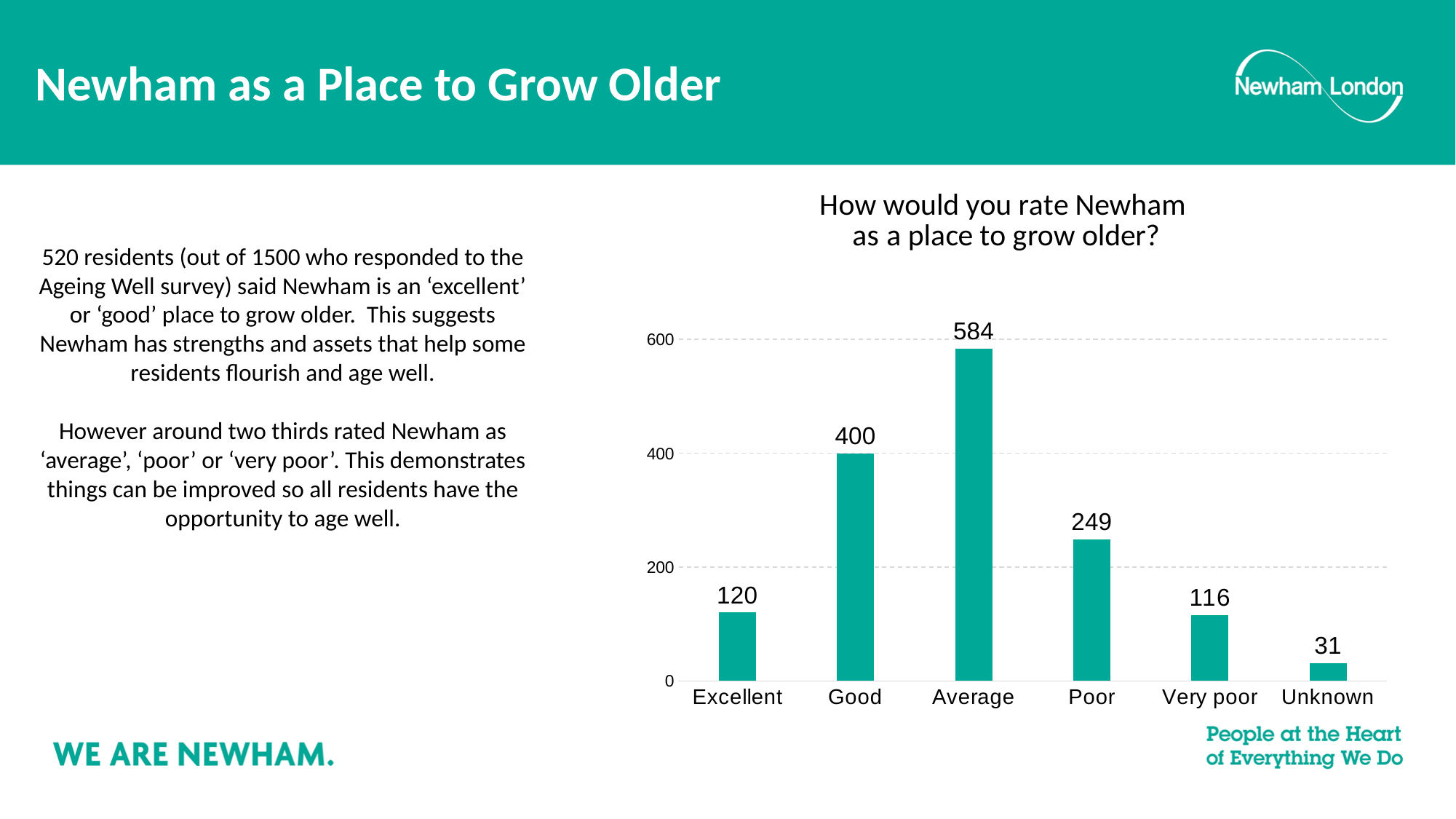
What is the value for Very poor? 116 Which category has the highest value? Average How many categories are shown on the x axis? 6 What is the title of the chart? How would you rate Newham as a place to grow older? Which is larger, the value for Excellent or the value for Poor? Poor Is the value for Good greater or less than 200? greater What is the value for Unknown? 31 What is the value for Average? 584 What is the difference between the values for Good and Poor? 151 What kind of chart is shown on the slide? bar chart Which category has the lowest value? Unknown What is the difference between the values for Excellent and Very poor? 4